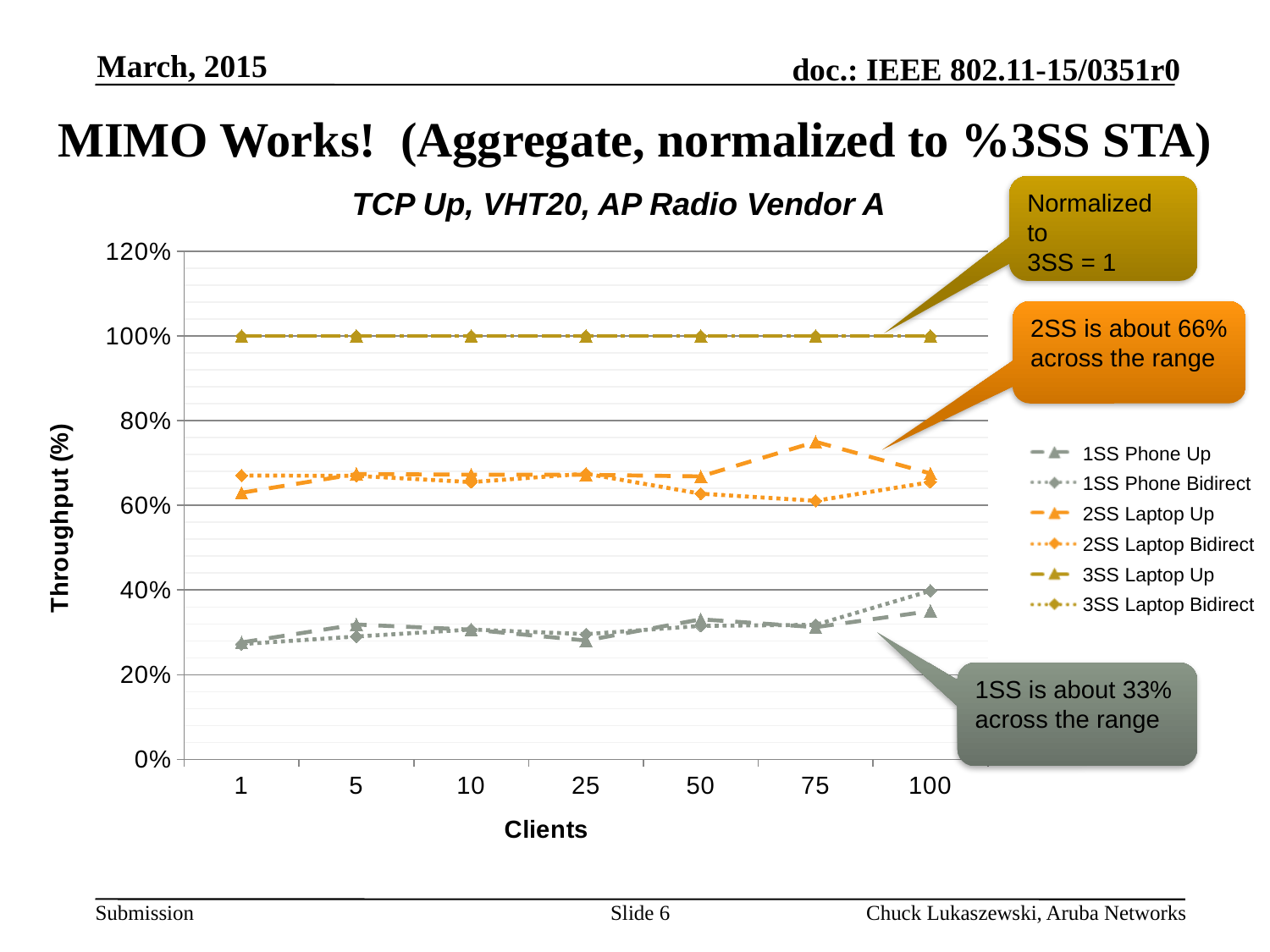
What is the title of the chart? TCP Up, VHT20, AP Radio Vendor A How does the 3SS Laptop Up series change as the number of clients increases from 1 to 100? It stays flat at 100% Is the value for 1SS Phone Up at 1 client greater or less than 40%? less How many series does the chart legend list? 6 At 25 clients, which is larger: 2SS Laptop Up or 1SS Phone Up? 2SS Laptop Up At 75 clients, which is larger: 2SS Laptop Up or 2SS Laptop Bidirect? 2SS Laptop Up What is the value of 3SS Laptop Bidirect at 1 client? 100% How many client counts are plotted along the x axis? 7 What kind of chart is shown on the slide? line chart Is the value for 1SS Phone Bidirect at 100 clients greater or less than 20%? greater Is the value for 2SS Laptop Up at 75 clients greater or less than 80%? less What is the value of 3SS Laptop Up at 50 clients? 100%